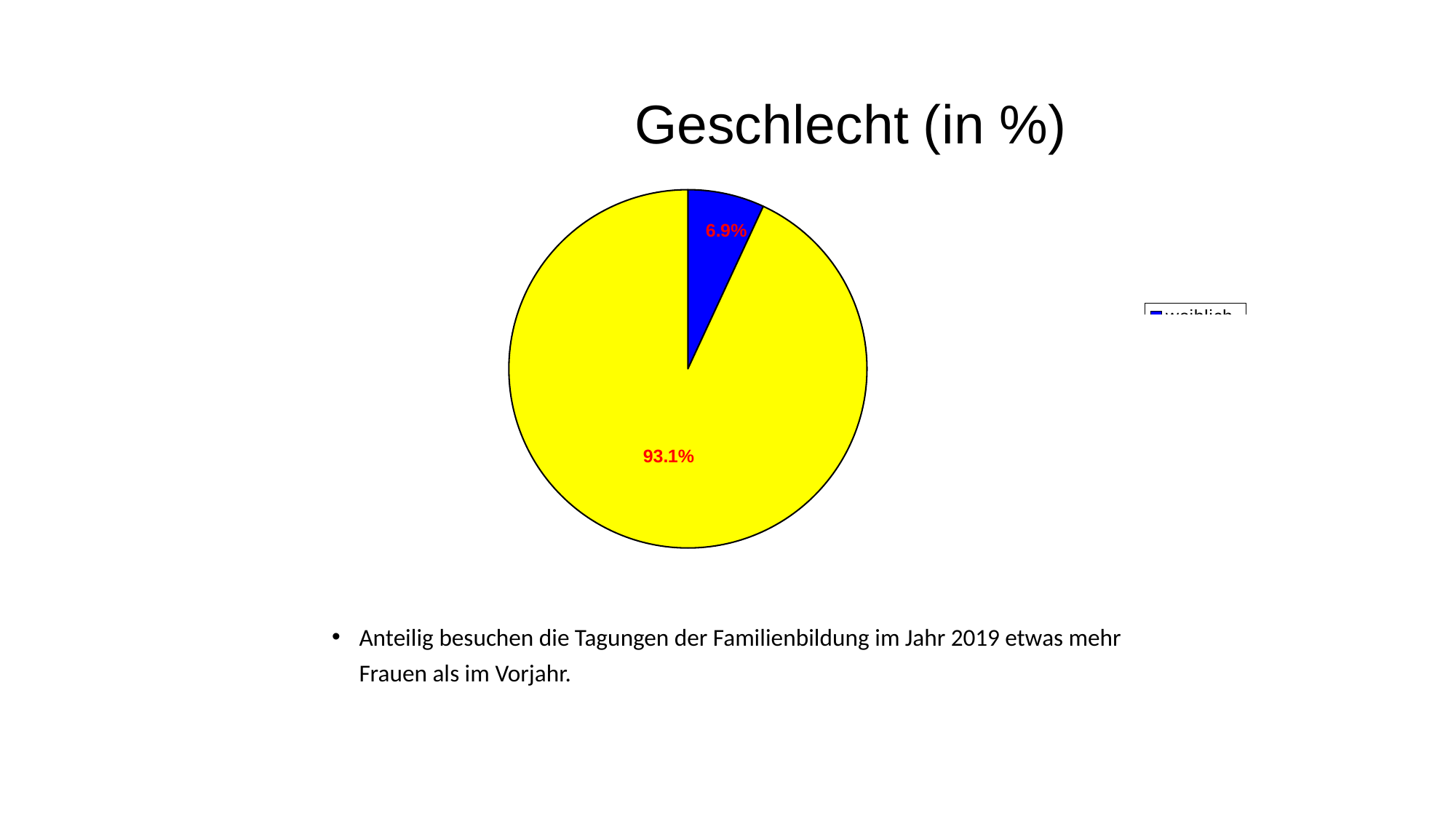
What share of the pie does the blue slice represent? 6.9% How many slices does the pie chart have? 2 Which is larger, the blue slice or the yellow slice? the yellow slice What percentage is shown on the yellow slice of the pie chart? 93.1% What percentage is shown on the blue slice of the pie chart? 6.9% Which slice of the pie chart is the largest? the yellow slice (93.1%) What kind of chart is shown on the slide? pie chart What is the difference between the yellow slice and the blue slice of the pie chart? 86.2% What is the title of the chart? Geschlecht (in %) What colour is the largest slice of the pie chart? yellow Which slice of the pie chart is the smallest? the blue slice (6.9%) What do the two slices of the pie chart add up to? 100%